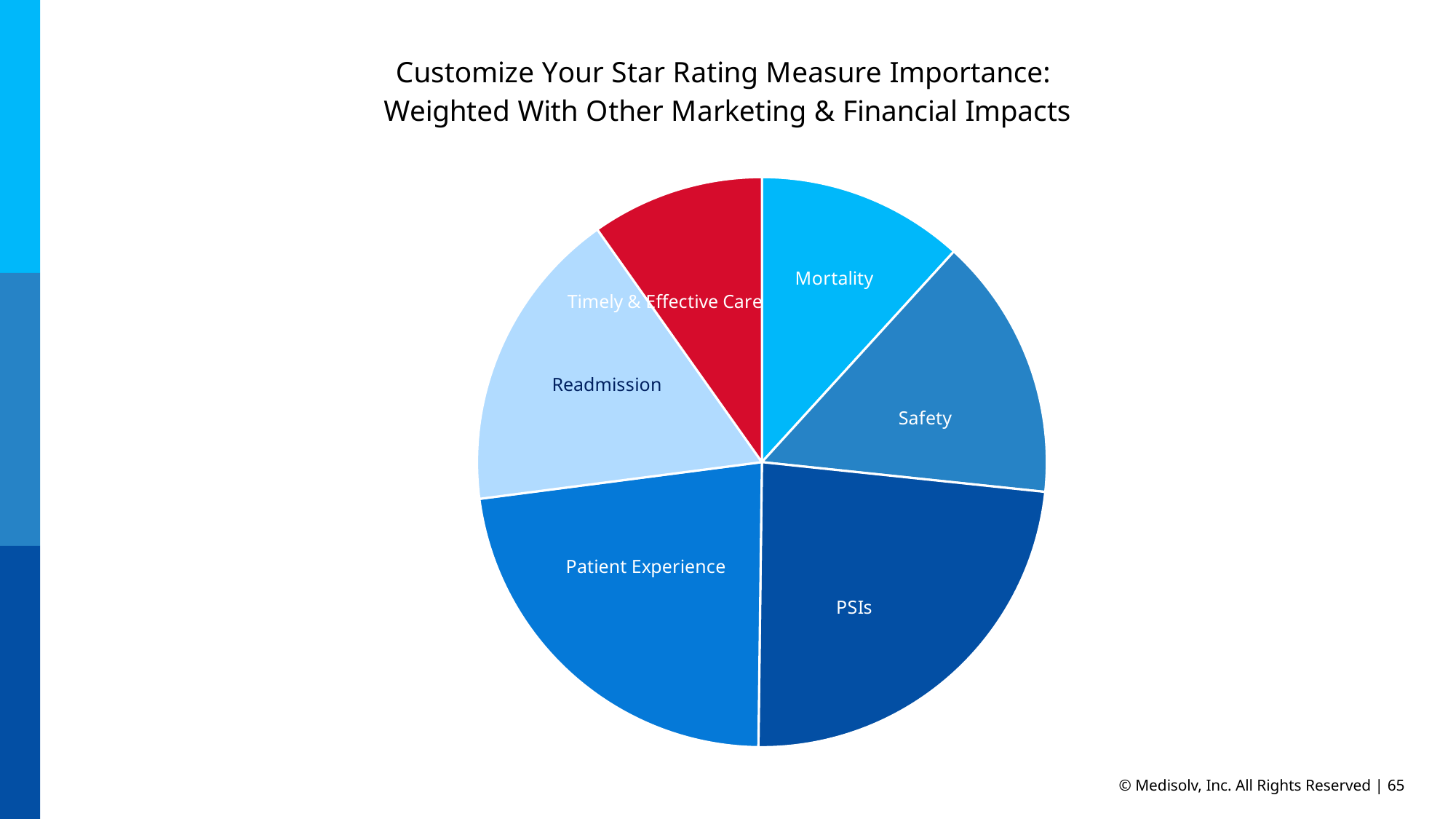
Which slice is larger, Readmission or Timely & Effective Care? Readmission Which slice is larger, PSIs or Mortality? PSIs Which slice is larger, Readmission or Mortality? Readmission What is the first line of the chart's title? Customize Your Star Rating Measure Importance: How many slices does the pie chart have? 6 What kind of chart is shown on the slide? pie chart Which slice of the pie chart is coloured red? Timely & Effective Care